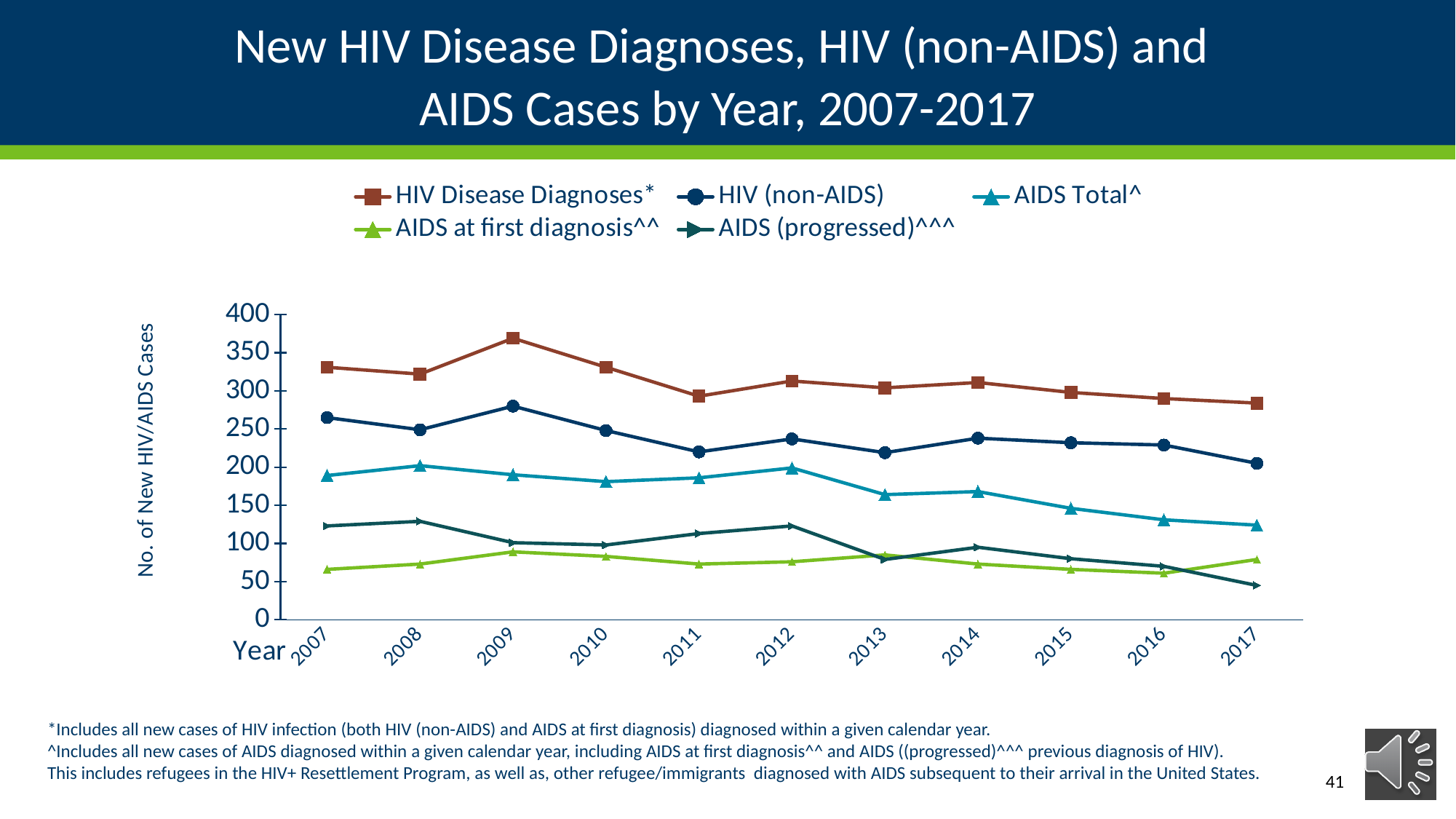
How many years are plotted along the x axis? 11 Does the AIDS Total^ series rise or fall from 2012 to 2017? fall What kind of chart is shown on the slide? line chart In which year is the HIV Disease Diagnoses* series highest? 2009 In which year is the AIDS (progressed)^^^ series lowest? 2017 Is the value for HIV (non-AIDS) in 2017 greater or less than 250? less Is the value for AIDS Total^ in 2017 greater or less than 150? less In which year is the HIV (non-AIDS) series highest? 2009 Is the value for HIV Disease Diagnoses* in 2009 greater or less than 350? greater How many series does the legend list? 5 In 2017, which is larger: AIDS at first diagnosis^^ or AIDS (progressed)^^^? AIDS at first diagnosis^^